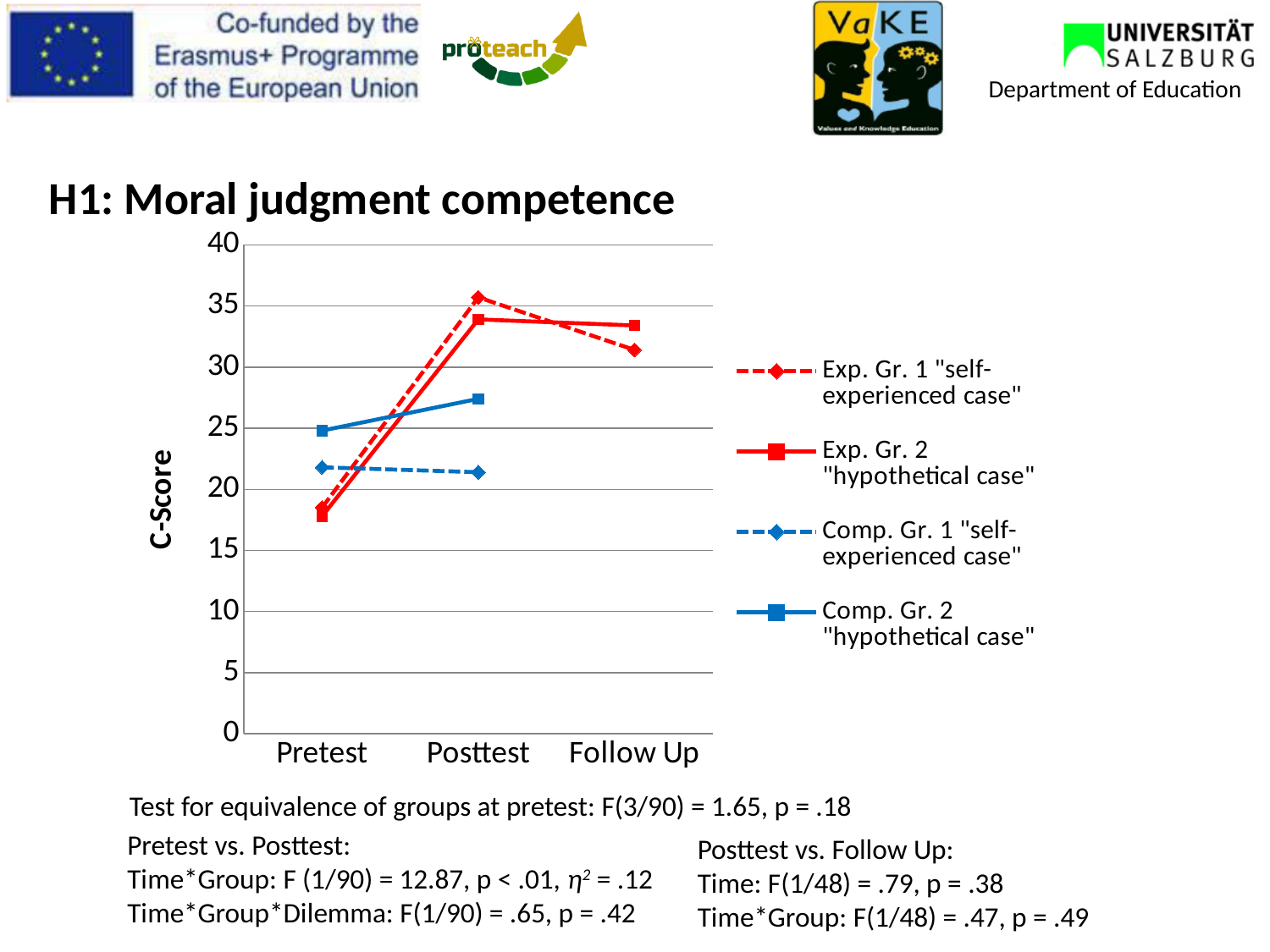
Which series has the lowest value at Posttest? Comp. Gr. 1 "self-experienced case" Is the Posttest value for Exp. Gr. 2 "hypothetical case" greater or less than 30? greater Is the Pretest value for Exp. Gr. 2 "hypothetical case" greater or less than 20? less What kind of chart is shown on the slide? line chart Does the value for Comp. Gr. 2 "hypothetical case" rise or fall from Pretest to Posttest? rise How many series does the chart legend list? 4 What is the label of the vertical axis of the chart? C-Score How many time points are shown on the x axis of the chart? 3 Which series has the highest value at Posttest? Exp. Gr. 1 "self-experienced case" At Follow Up, which series has the larger value: Exp. Gr. 1 "self-experienced case" or Exp. Gr. 2 "hypothetical case"? Exp. Gr. 2 "hypothetical case" Is the Follow Up value for Exp. Gr. 1 "self-experienced case" greater or less than 30? greater At Pretest, which series has the larger value: Comp. Gr. 2 "hypothetical case" or Exp. Gr. 2 "hypothetical case"? Comp. Gr. 2 "hypothetical case"